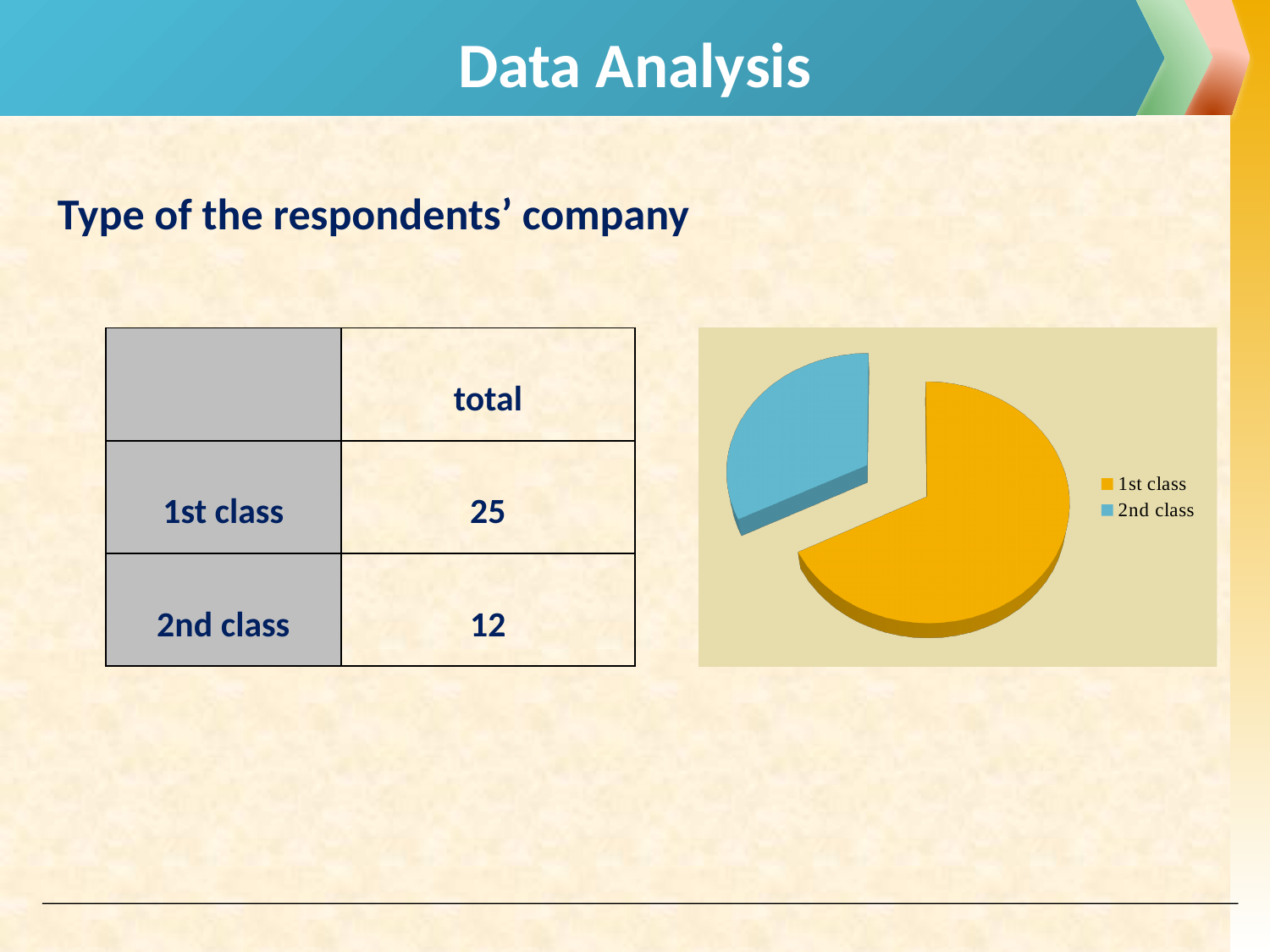
What kind of chart is shown on the slide? pie chart According to the table next to the pie chart, what is the total for 2nd class? 12 Which category has the smallest slice in the pie chart? 2nd class What colour is the 2nd class slice in the pie chart? blue Which slice is larger in the pie chart, 1st class or 2nd class? 1st class Using the values in the table, what is the difference between the 1st class and 2nd class totals? 13 What colour is the 1st class slice in the pie chart? orange According to the table next to the pie chart, what is the total for 1st class? 25 How many entries does the pie chart's legend list? 2 Using the values in the table, what is the combined total of 1st class and 2nd class respondents? 37 How many slices does the pie chart have? 2 Which category has the largest slice in the pie chart? 1st class